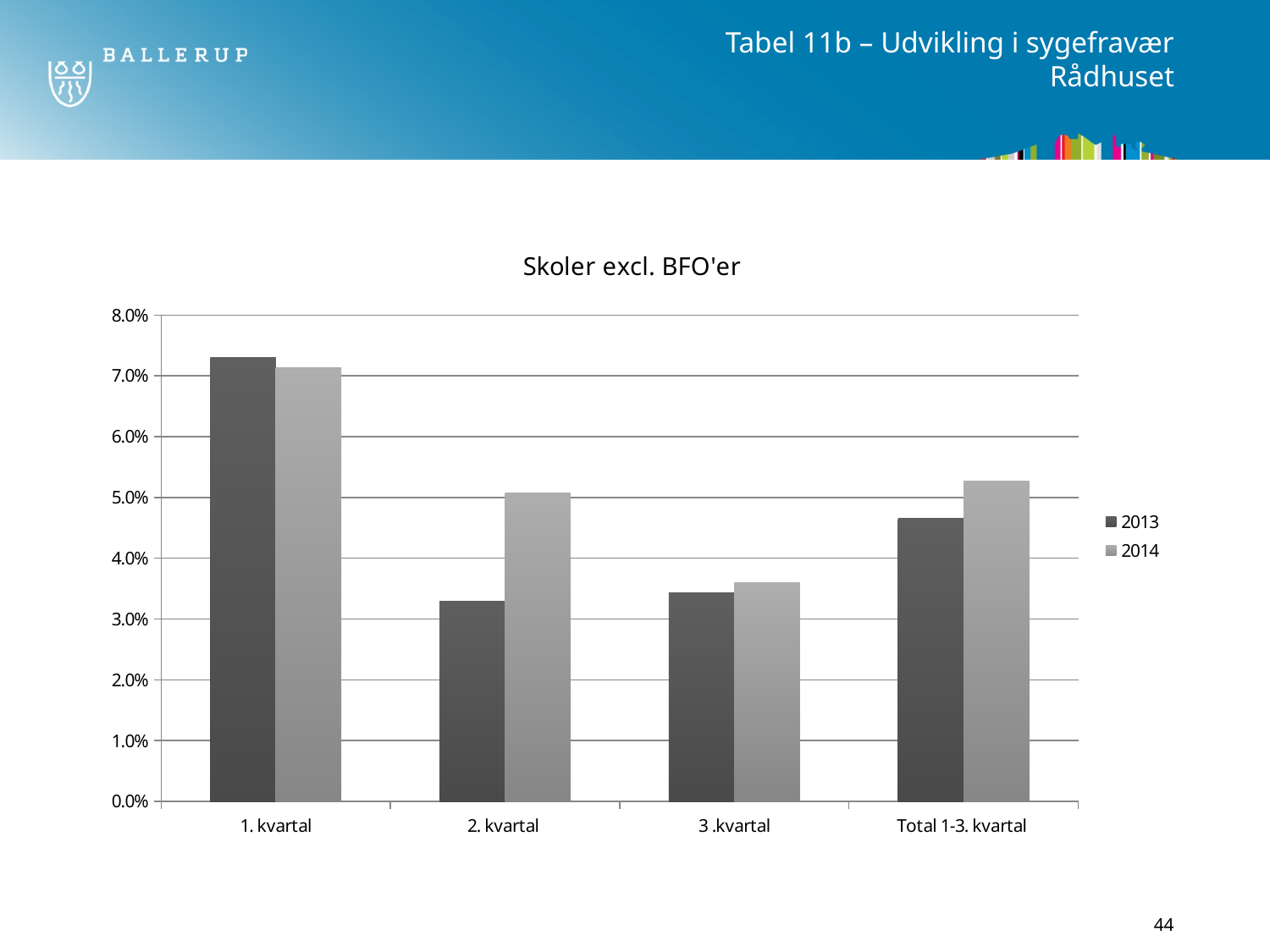
Which category has the lowest value for 2014? 3 .kvartal Which category has the highest value for 2013? 1. kvartal Is the 2013 value for Total 1-3. kvartal greater or less than 5.0%? less For 2. kvartal, which is larger: the 2013 value or the 2014 value? 2014 What is the title of the chart? Skoler excl. BFO'er How many series does the legend list? 2 Is the 2013 value for 2. kvartal greater or less than 4.0%? less Is the 2013 value for 1. kvartal greater or less than 7.0%? greater What kind of chart is shown on the slide? bar chart Does the 2013 value rise or fall from 1. kvartal to 2. kvartal? fall How many categories are shown on the x axis? 4 For Total 1-3. kvartal, which is larger: the 2013 value or the 2014 value? 2014